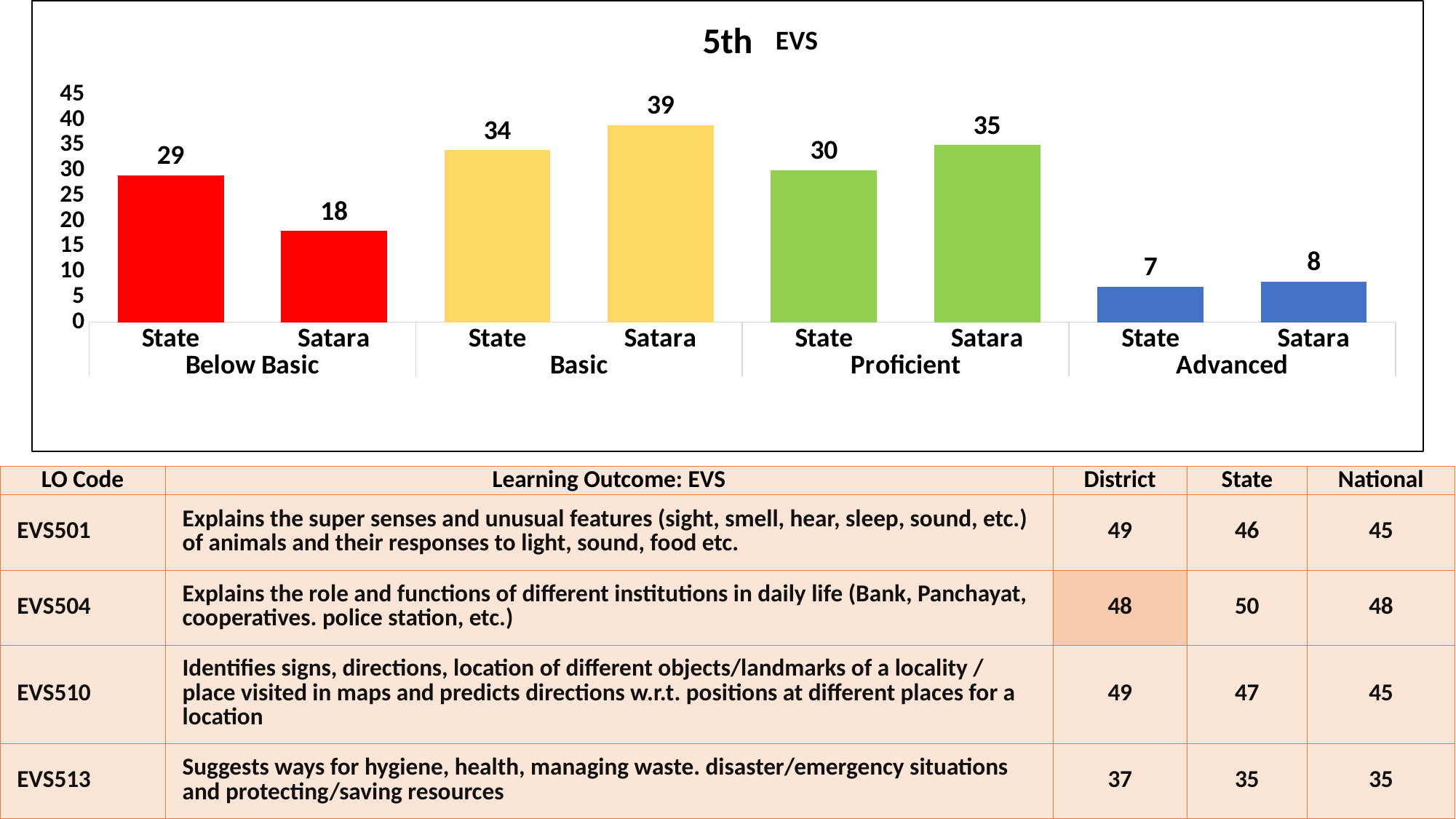
How many performance level groups are shown on the x axis? 4 What is the title of the chart? 5th EVS Which bar has the highest value in the chart? Satara, Basic What is the difference between the State and Satara values in the Below Basic group? 11 What kind of chart is shown on the slide? bar chart What is the value for State in the Advanced group? 7 What is the value for Satara in the Proficient group? 35 What is the value for State in the Below Basic group? 29 How many bars are plotted in the chart? 8 Which bar has the lowest value in the chart? State, Advanced What is the value for Satara in the Basic group? 39 In the Proficient group, which is larger, the State value or the Satara value? Satara